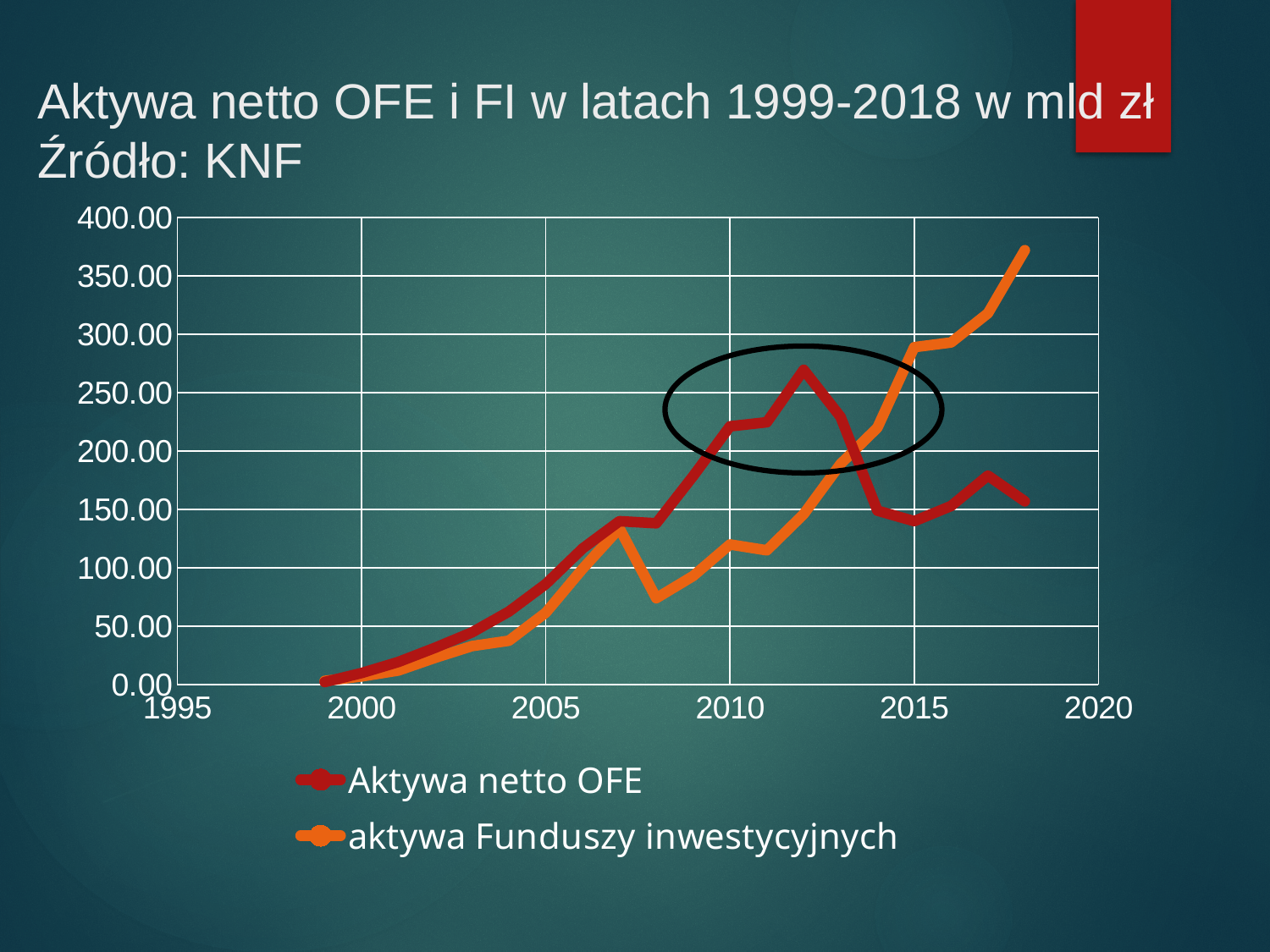
Is the value for aktywa Funduszy inwestycyjnych in 2018 greater or less than 350? greater Is the value for Aktywa netto OFE in 2015 greater or less than 200? less Is the value for aktywa Funduszy inwestycyjnych in 2015 greater or less than 250? greater In 2018, which series has the higher value, Aktywa netto OFE or aktywa Funduszy inwestycyjnych? aktywa Funduszy inwestycyjnych How many series does the legend list? 2 Does the aktywa Funduszy inwestycyjnych series rise or fall between 2015 and 2018? rise What kind of chart is shown on the slide? line chart In 2012, which series has the higher value, Aktywa netto OFE or aktywa Funduszy inwestycyjnych? Aktywa netto OFE Which series is drawn in orange? aktywa Funduszy inwestycyjnych What is the title of the chart? Aktywa netto OFE i FI w latach 1999-2018 w mld zł